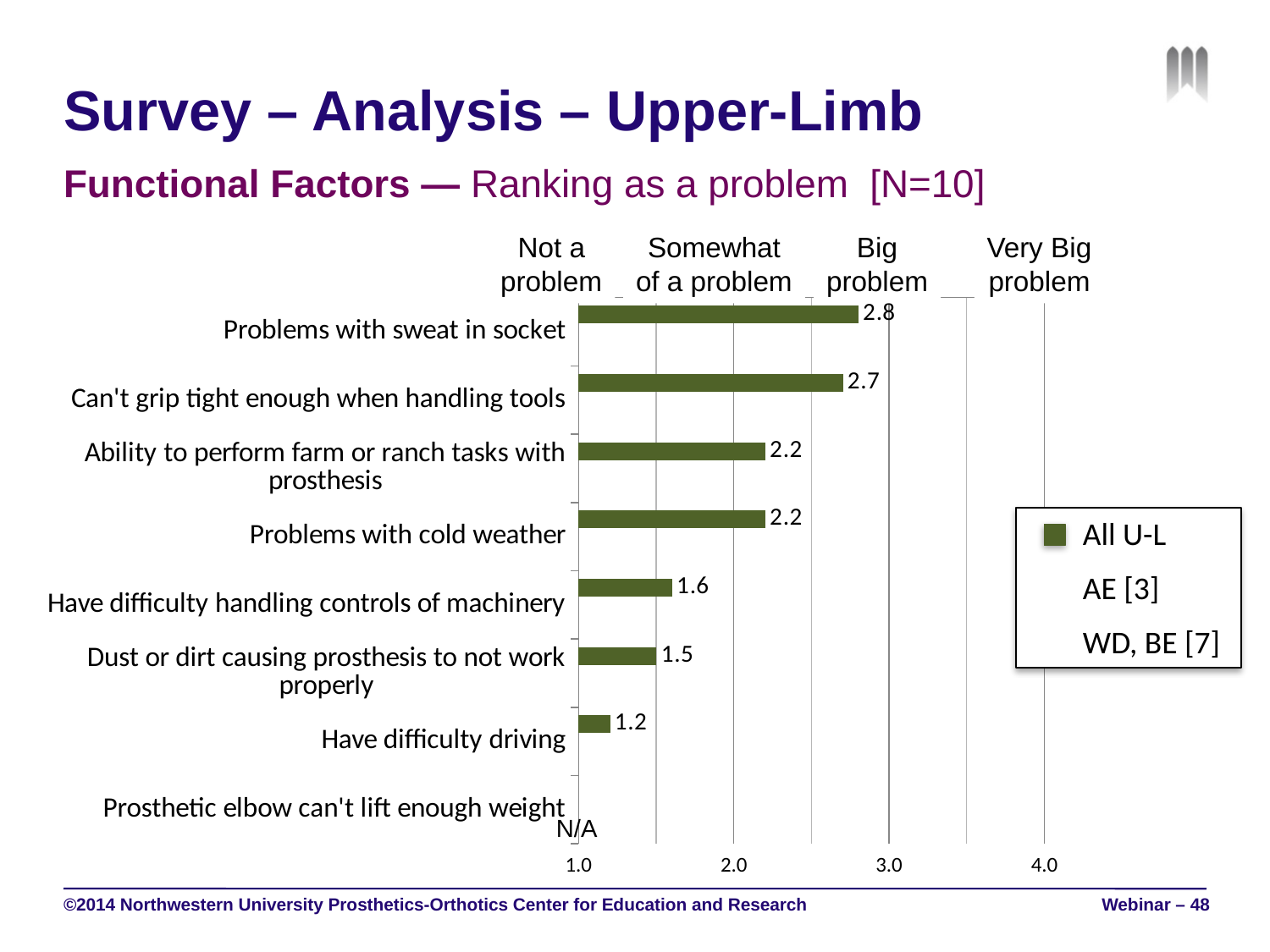
What is the value for "Have difficulty handling controls of machinery"? 1.6 Is the value for "Ability to perform farm or ranch tasks with prosthesis" greater or less than 2.0? greater What is the value for "Problems with sweat in socket"? 2.8 Which is larger, the value for "Problems with cold weather" or the value for "Dust or dirt causing prosthesis to not work properly"? Problems with cold weather What is the value for "Have difficulty driving"? 1.2 Which category has the highest value? Problems with sweat in socket What is shown for "Prosthetic elbow can't lift enough weight"? N/A What is the difference between the values for "Problems with sweat in socket" and "Have difficulty driving"? 1.6 How many categories are listed on the chart? 8 What kind of chart is shown on the slide? bar chart What is the value for "Can't grip tight enough when handling tools"? 2.7 Which category with a plotted bar has the lowest value? Have difficulty driving